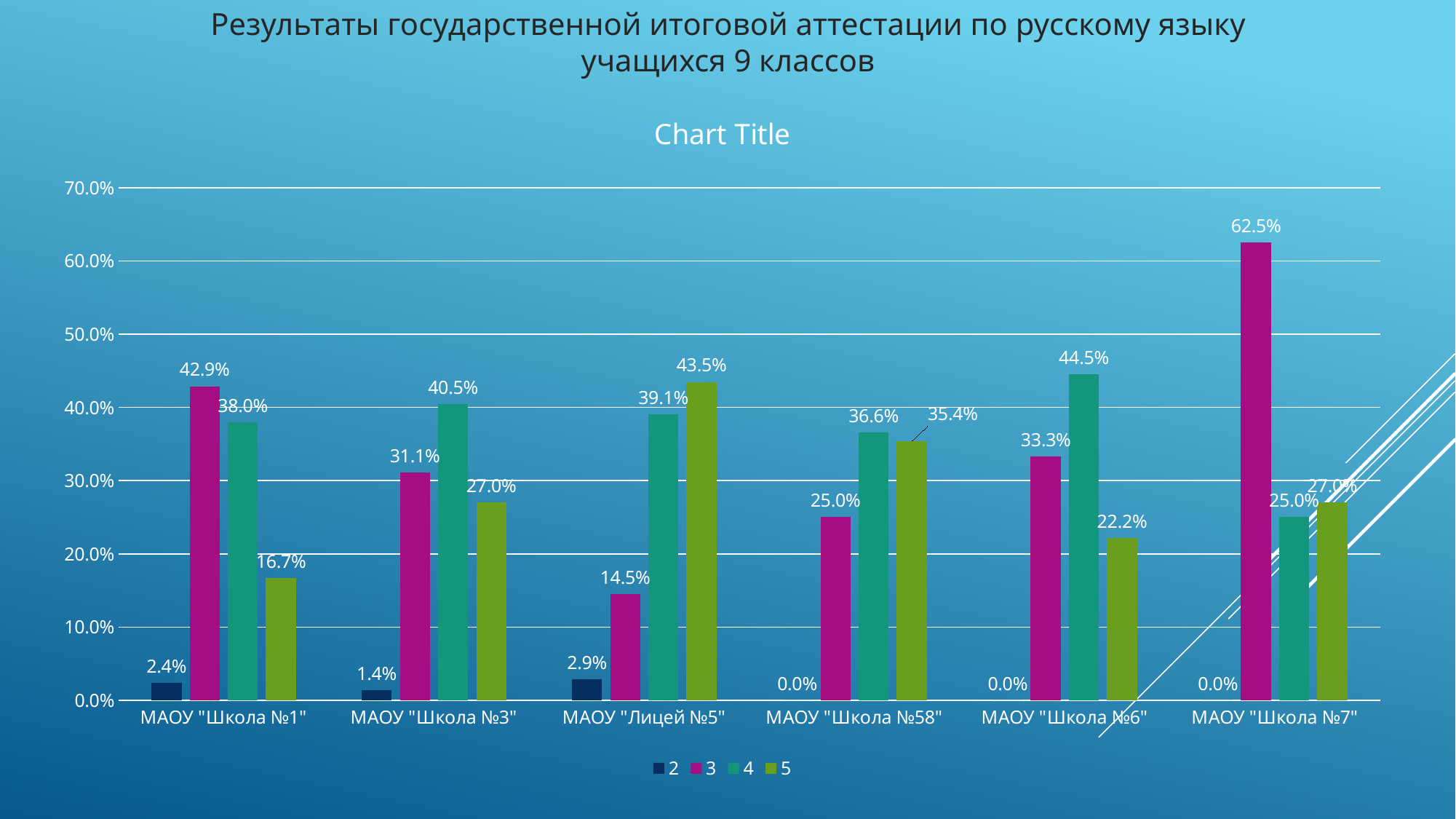
What is the value of series 2 for МАОУ "Лицей №5"? 2.9% How many series does the legend list? 4 What is the difference between series 3 and series 4 for МАОУ "Школа №1"? 4.9% Which school has the highest value for series 3? МАОУ "Школа №7" What is the title shown directly above the chart area? Chart Title Which school has the lowest value for series 5? МАОУ "Школа №1" What type of chart is shown on the slide? bar chart What is the value of series 4 for МАОУ "Школа №6"? 44.5% What is the value of series 3 for МАОУ "Школа №7"? 62.5% How many schools (categories) are shown on the x axis? 6 For МАОУ "Школа №3", which is larger: series 4 or series 5? series 4 What is the value of series 5 for МАОУ "Школа №58"? 35.4%